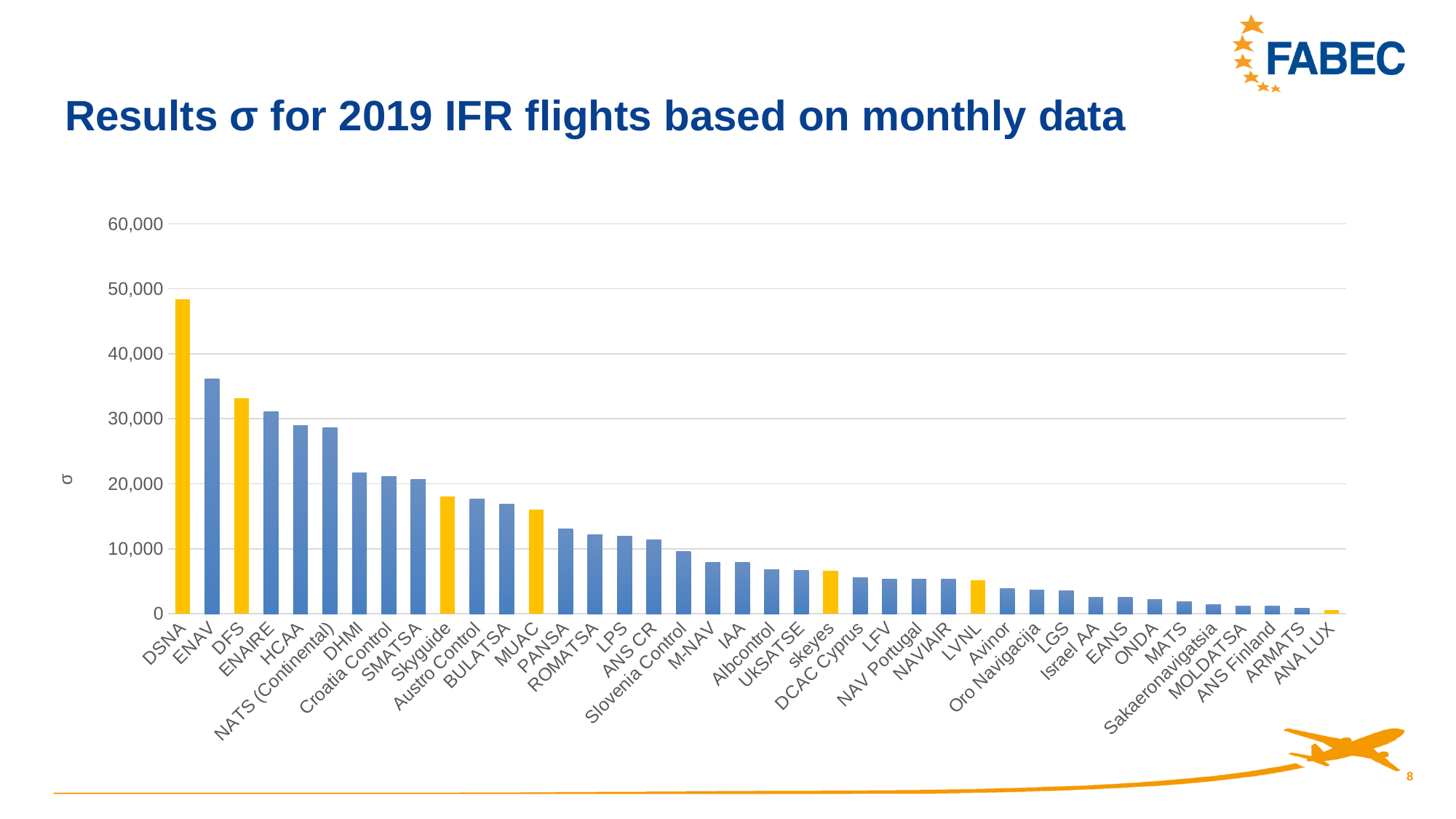
Is the value for PANSA greater or less than 10,000? greater How many categories are plotted on the x axis? 40 What is the label on the y axis? σ Which category has the highest σ value? DSNA Is the value for Skyguide greater or less than 20,000? less Which is larger, the value for DSNA or the value for ENAV? DSNA Which category has the lowest σ value? ANA LUX Is the value for DSNA greater or less than 40,000? greater What kind of chart is shown on the slide? bar chart Do the values rise or fall moving from left to right along the x axis? fall